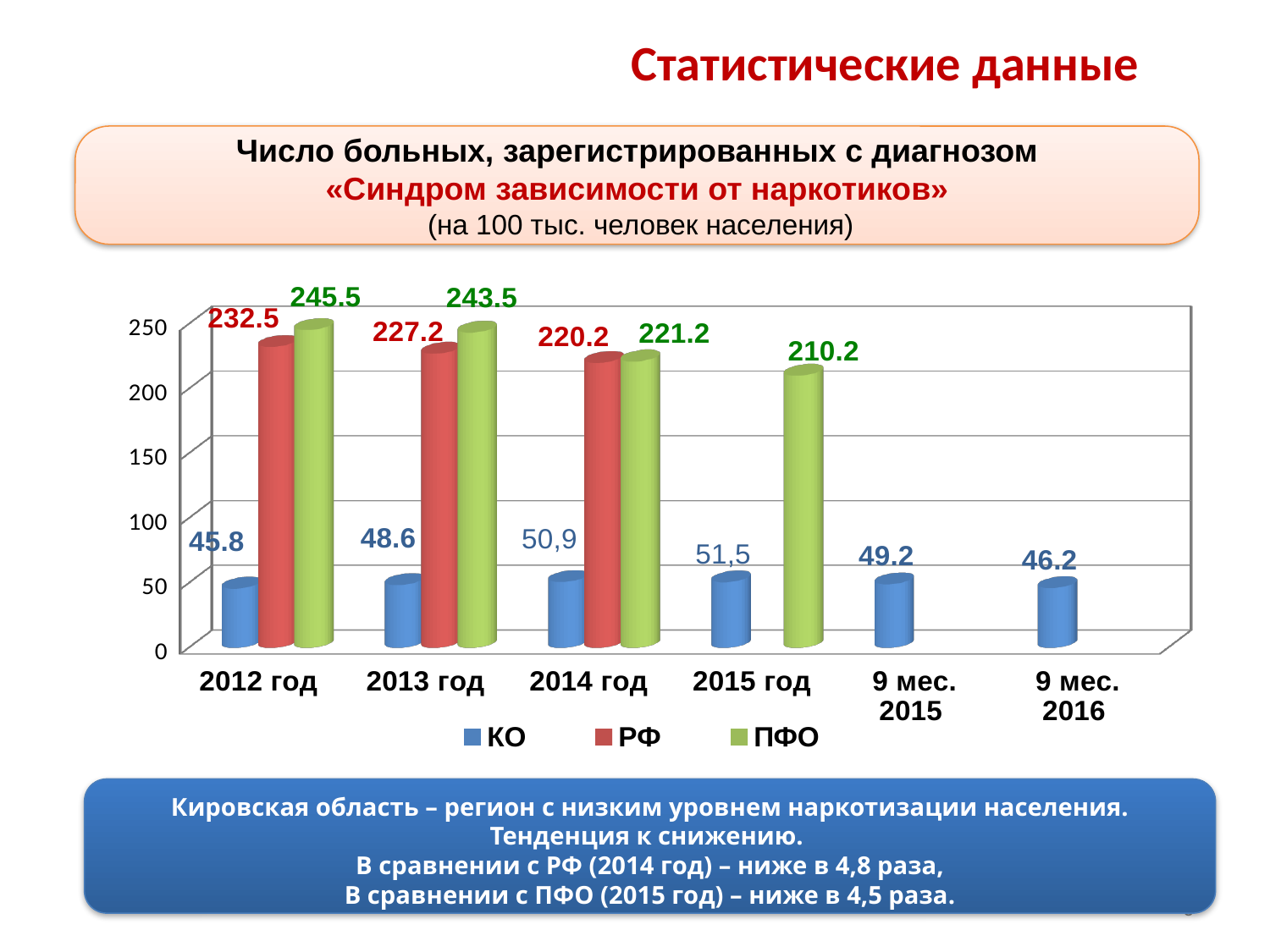
How many series does the legend list? 3 Do the ПФО values rise or fall from 2012 год to 2015 год? fall What kind of chart is shown on the slide? bar chart What is the value for КО in 9 мес. 2016? 46.2 What is the value for РФ in 2012 год? 232.5 How many categories are shown on the x axis? 6 What is the difference between the ПФО and РФ values in 2012 год? 13.0 Which is larger in 2014 год, the РФ value or the ПФО value? ПФО What is the value for ПФО in 2015 год? 210.2 In which category is the КО value highest? 2015 год In which category is the КО value lowest? 2012 год What is the value for КО in 2015 год? 51,5